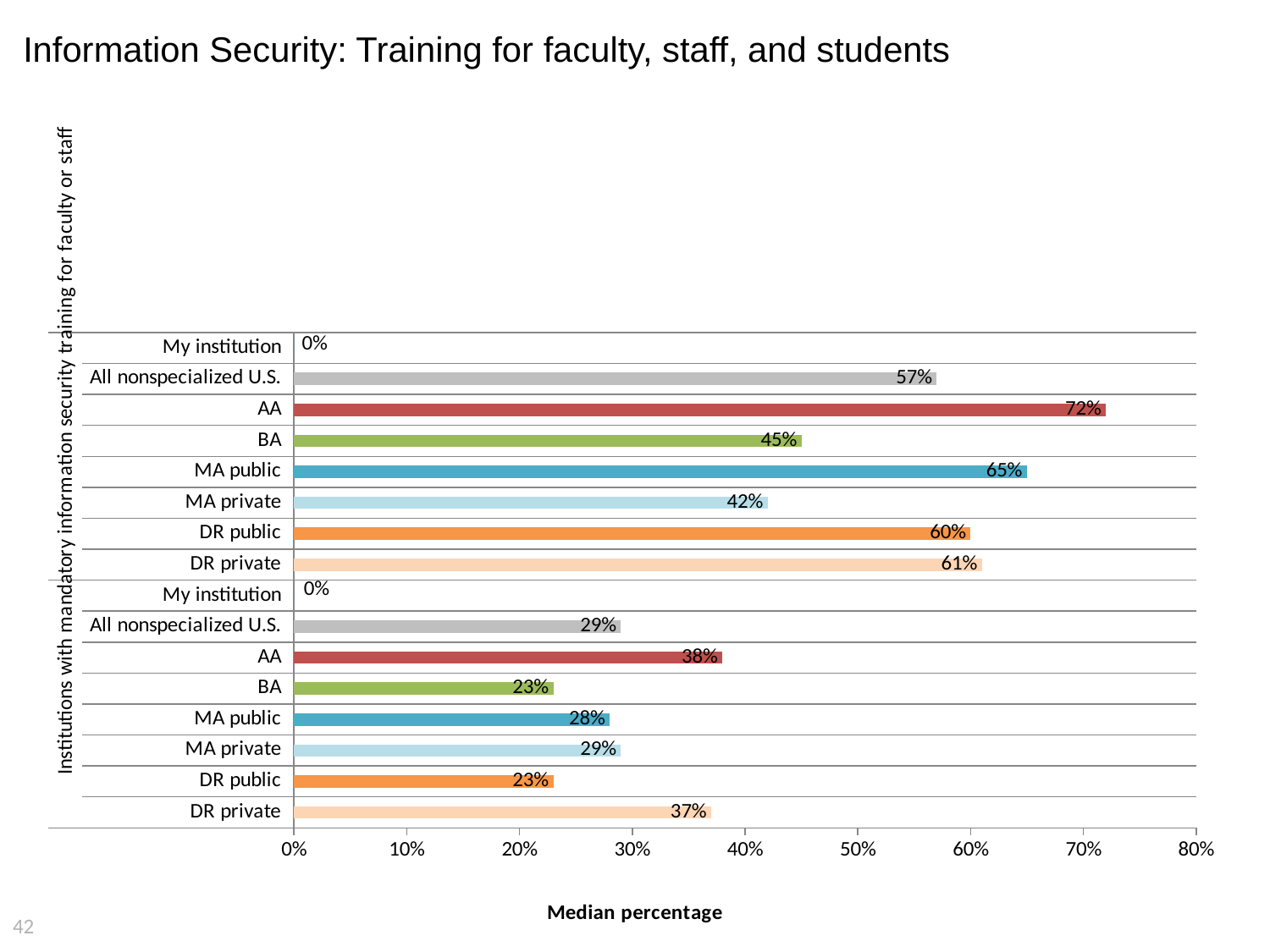
In the top group of bars, which category has the highest value? AA In the top group of bars, what is the value for MA private? 42% In the top group of bars, what is the value for AA? 72% In the bottom group of bars, which is larger, the value for MA public or the value for DR private? DR private In the top group of bars, what is the difference between the values for AA and BA? 27% In the bottom group of bars, which category has the highest value? AA What kind of chart is shown on the slide? bar chart In the bottom group of bars, what is the value for DR private? 37% In the bottom group of bars, what is the value for All nonspecialized U.S.? 29% In the top group of bars, what is the difference between the values for MA public and MA private? 23% What is the label on the horizontal axis of the chart? Median percentage